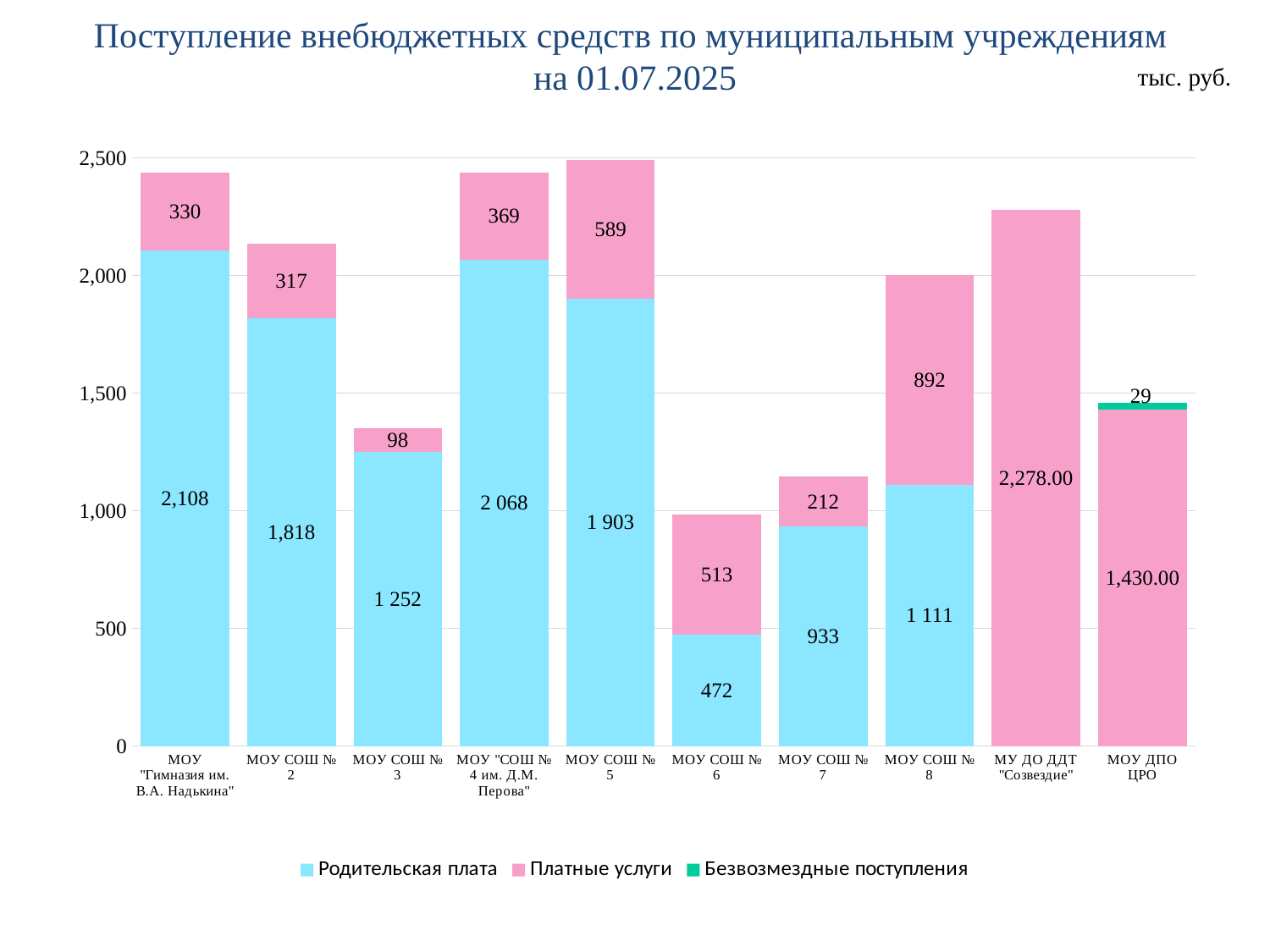
How many institutions are shown on the x axis? 10 Which institution has the lowest value of Платные услуги? МОУ СОШ № 3 What kind of chart is shown on the slide? Stacked bar chart What is the value of Родительская плата for МОУ СОШ № 5? 1 903 What is the total of the stacked bar for МОУ СОШ № 6? 985 What is the difference between the Платные услуги values for МОУ СОШ № 5 and МОУ СОШ № 6? 76 What is the value of Безвозмездные поступления for МОУ ДПО ЦРО? 29 Which has a larger Родительская плата value, МОУ СОШ № 2 or МОУ СОШ № 7? МОУ СОШ № 2 What is the value of Платные услуги for МУ ДО ДДТ "Созвездие"? 2,278.00 Which institution has the highest value of Родительская плата? МОУ "Гимназия им. В.А. Надькина" How many series does the legend list? 3 What is the value of Платные услуги for МОУ СОШ № 8? 892